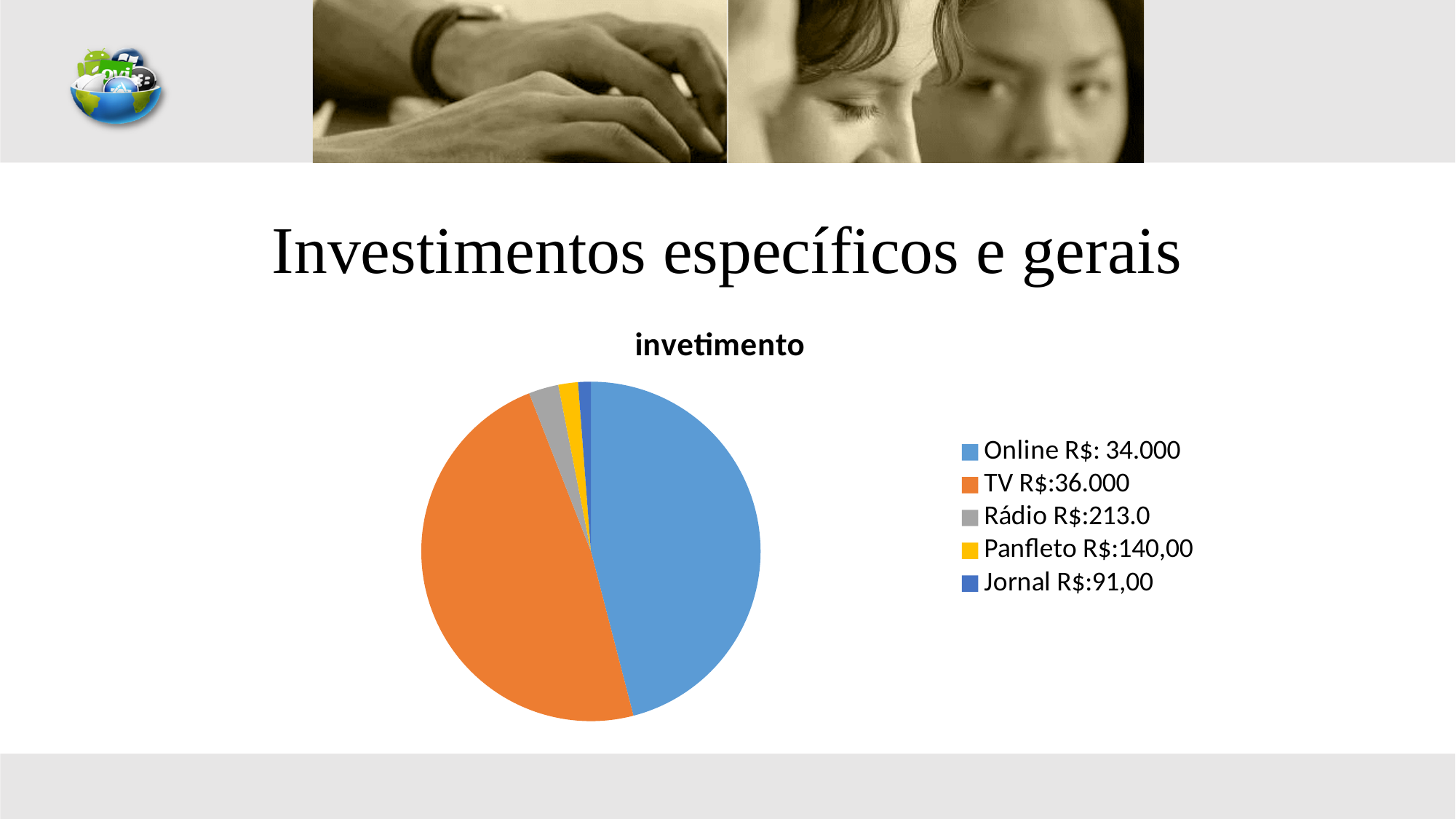
What amount is shown in the legend for Rádio? R$:213.0 How many entries does the legend list? 5 What amount is shown in the legend for Panfleto? R$:140,00 What amount is shown in the legend for Online? R$: 34.000 What amount is shown in the legend for TV? R$:36.000 Which category has the smallest slice of the pie? Jornal Which slice is larger, Rádio or Panfleto? Rádio What is the title of the chart? invetimento Which colour represents TV in the pie chart? orange What amount is shown in the legend for Jornal? R$:91,00 What kind of chart is shown on the slide? pie chart How many categories (slices) does the pie chart have? 5